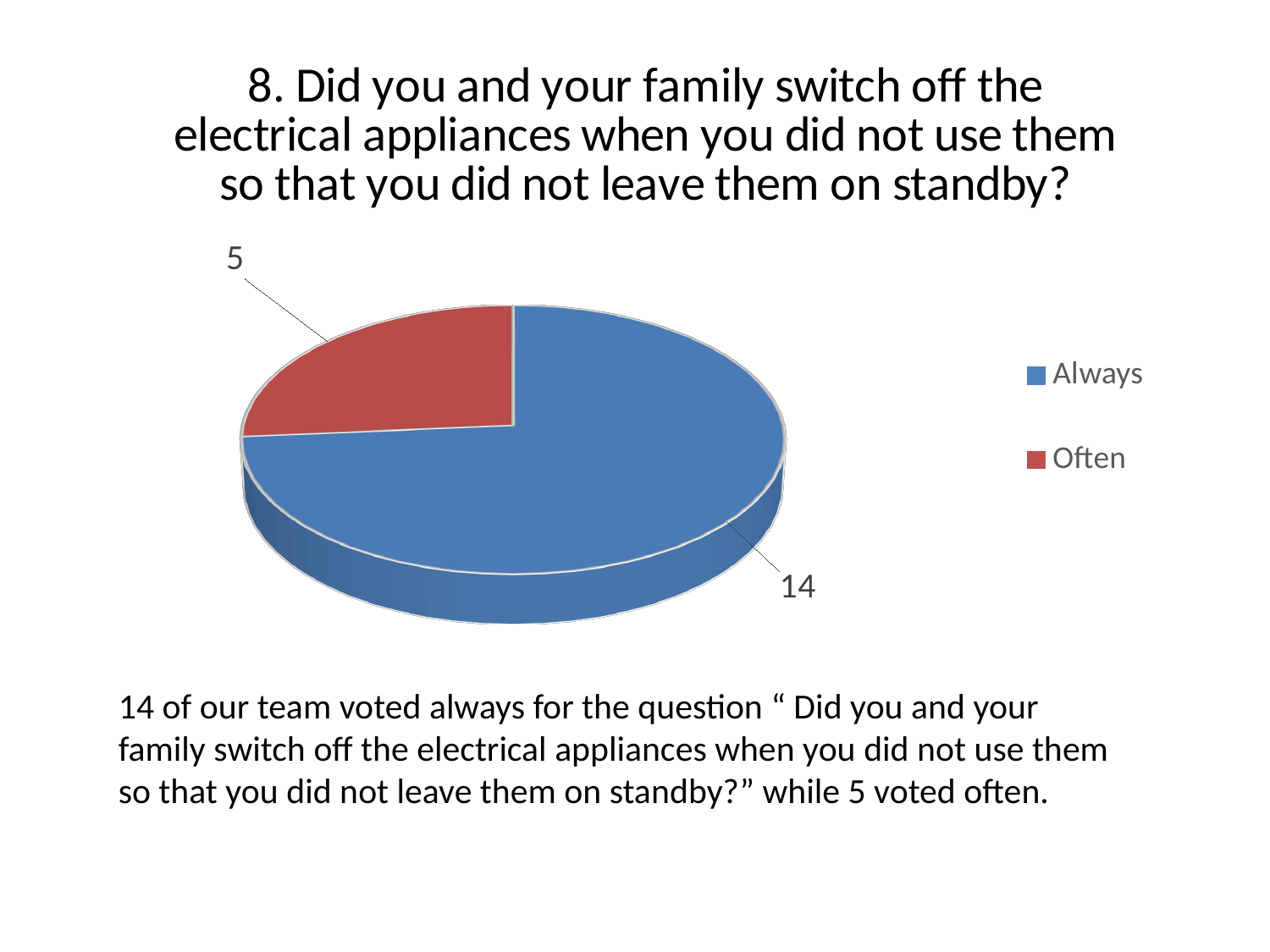
How many people voted Always? 14 What is the total of all slices in the pie chart? 19 How many categories does the pie chart have? 2 How many people voted Often? 5 Which colour represents Always in the pie chart? blue What is the difference between the Always and Often values? 9 How many entries does the legend list? 2 Which category has the smallest slice of the pie? Often Which is larger, the value for Always or the value for Often? Always Which category has the largest slice of the pie? Always What kind of chart is shown on the slide? pie chart Which colour represents Often in the pie chart? red